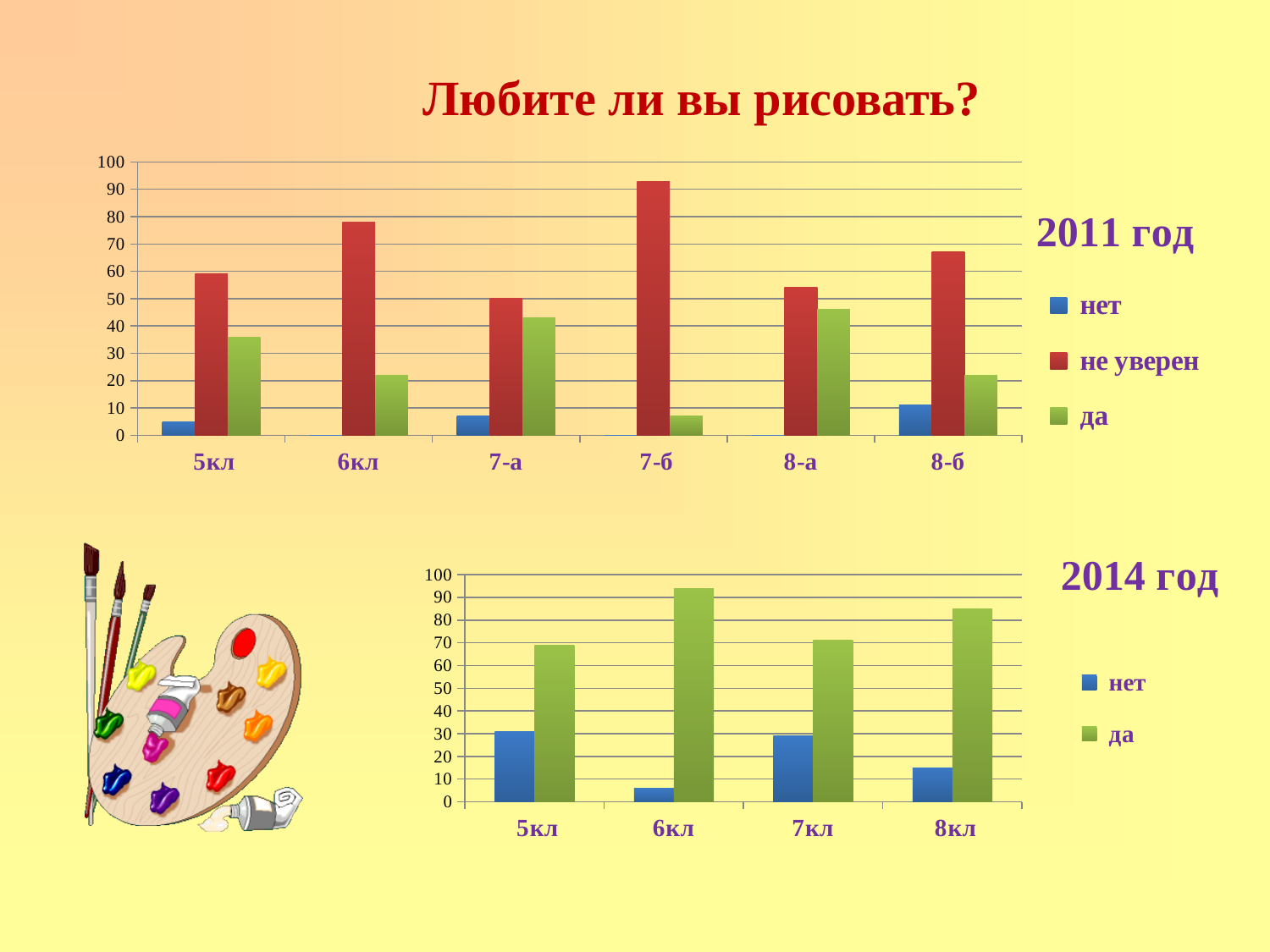
How many series does the legend of the 2011 год chart list? 3 In the 2014 год chart, which category has the lowest value for "нет"? 6кл What type of chart is the 2014 год chart? bar chart In the 2011 год chart, which category has the highest value for "не уверен"? 7-б In the 2011 год chart, which category has the lowest value for "да"? 7-б How many categories are shown on the x axis of the 2014 год chart? 4 How many categories are shown on the x axis of the 2011 год chart? 6 In the 2011 год chart, is the value for "да" in 5кл greater or less than 40? less In the 2014 год chart, is the value for "да" in 8кл greater or less than 80? greater In the 2014 год chart, which category has the highest value for "да"? 6кл In the 2011 год chart, is the value for "не уверен" in 6кл greater or less than 70? greater In the 2014 год chart, which is larger: the "нет" value for 5кл or the "нет" value for 8кл? 5кл